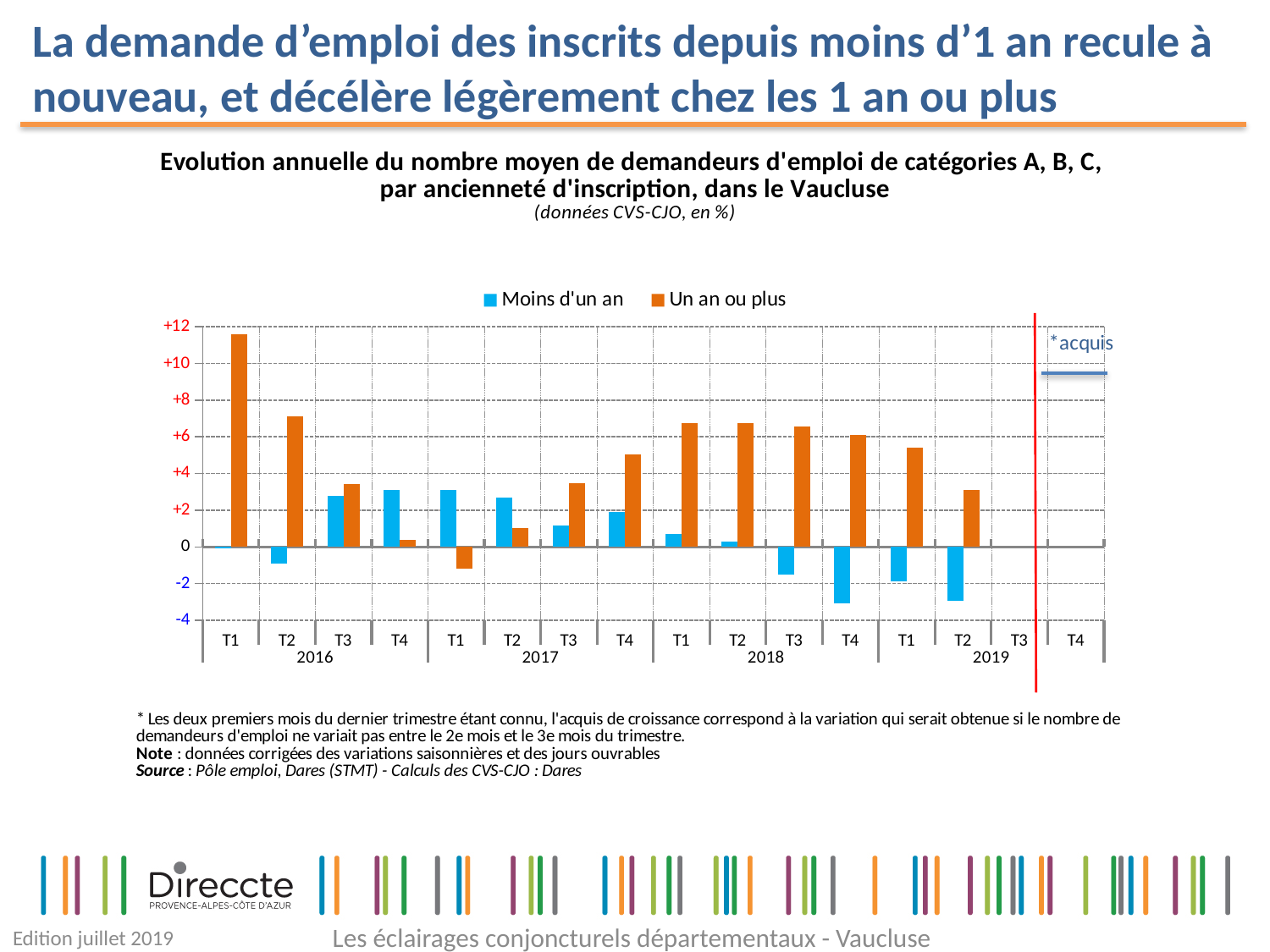
What kind of chart is shown on the slide? bar chart In which quarter is the value for 'Un an ou plus' highest? T1 2016 Is the value for 'Un an ou plus' in T1 2016 greater or less than +10? greater How many series does the legend list? 2 What are the two series named in the legend? Moins d'un an; Un an ou plus In T2 2017, which series has the larger value, 'Moins d'un an' or 'Un an ou plus'? Moins d'un an Is the value for 'Moins d'un an' in T4 2018 greater or less than -2? less How many years are labelled along the x axis? 4 Which series is drawn in orange? Un an ou plus Is the value for 'Un an ou plus' in T1 2019 greater or less than +4? greater In which quarter is the value for 'Un an ou plus' lowest? T1 2017 Does the value for 'Moins d'un an' rise or fall from T1 2018 to T4 2018? fall